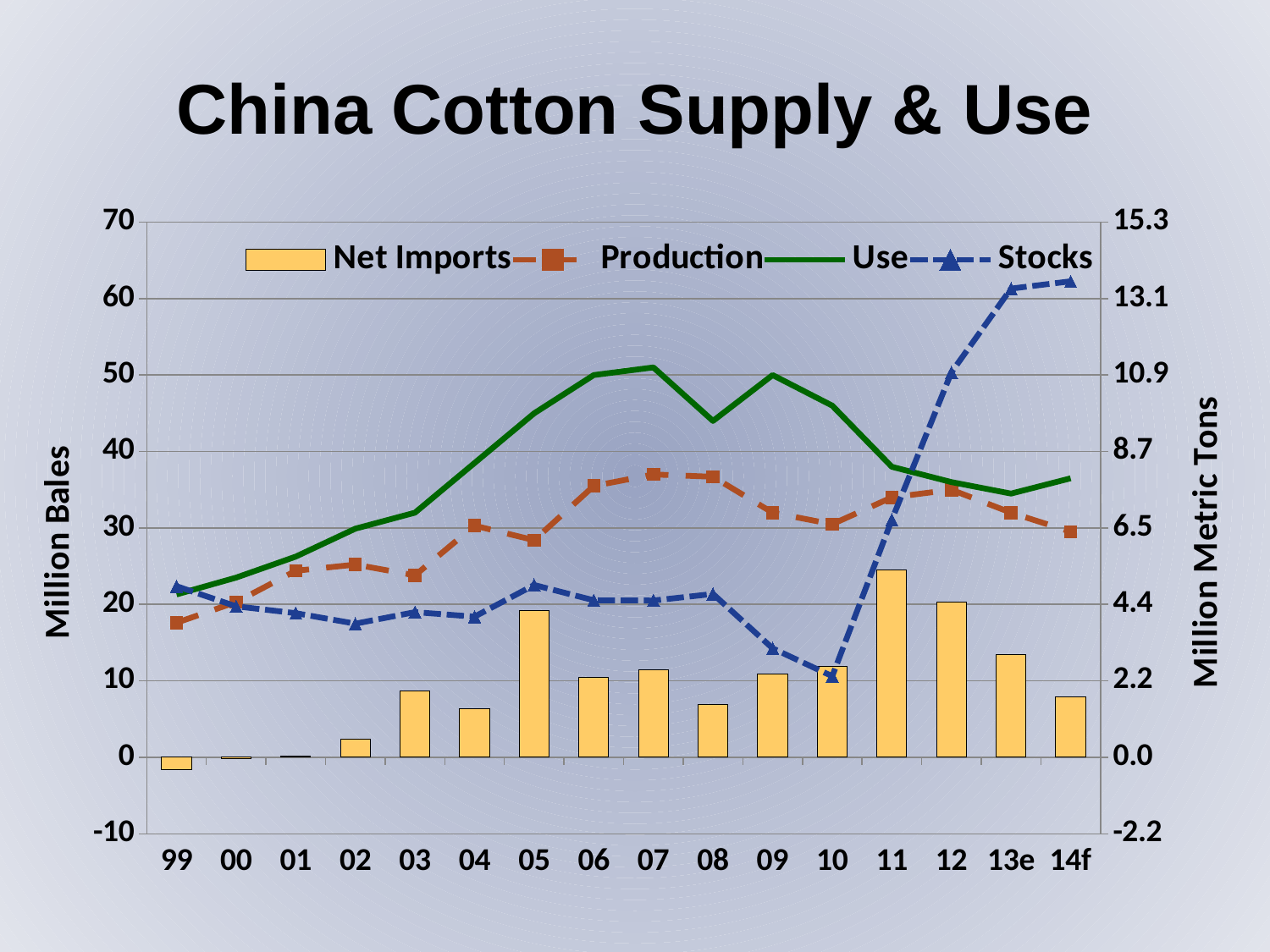
How many years are shown along the x axis? 16 Does the Stocks line rise or fall from 10 to 13e? Rise Is the Stocks value for 12 greater or less than 40 on the left axis? greater What kind of chart is shown on the slide? A combination bar and line chart In which year is the Use line at its lowest? 99 What is the label of the right-hand vertical axis? Million Metric Tons In which year are Net Imports highest? 11 In which year is the Stocks line at its lowest? 10 Is the Production value for 99 greater or less than 20? less How many series does the legend list? 4 Is the Net Imports value for 11 greater or less than 20? greater In 07, which is larger, Use or Production? Use